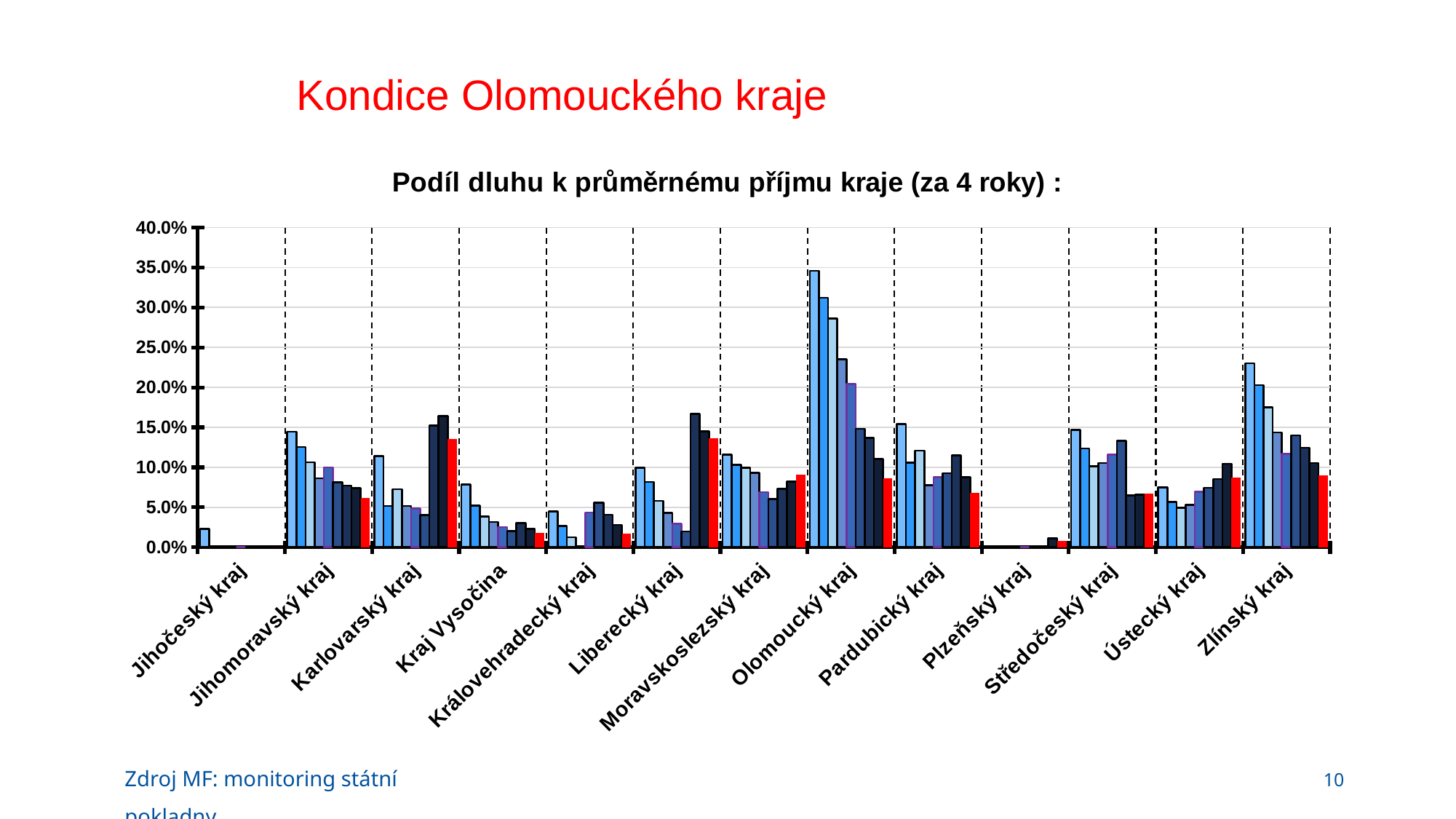
Which region has the tallest bar in the chart? Olomoucký kraj How many regions (categories) are shown on the x axis of the chart? 13 Is the tallest bar for Kraj Vysočina greater or less than 10.0%? less Is the tallest bar for Jihočeský kraj greater or less than 5.0%? less What kind of chart is shown on the slide? bar chart What is the highest value shown on the vertical axis of the chart? 40.0% Is the tallest bar for Zlínský kraj greater or less than 20.0%? greater Which region has the taller maximum bar, Olomoucký kraj or Zlínský kraj? Olomoucký kraj Which region has the lowest bars in the chart? Plzeňský kraj What is the title of the chart? Podíl dluhu k průměrnému příjmu kraje (za 4 roky) :